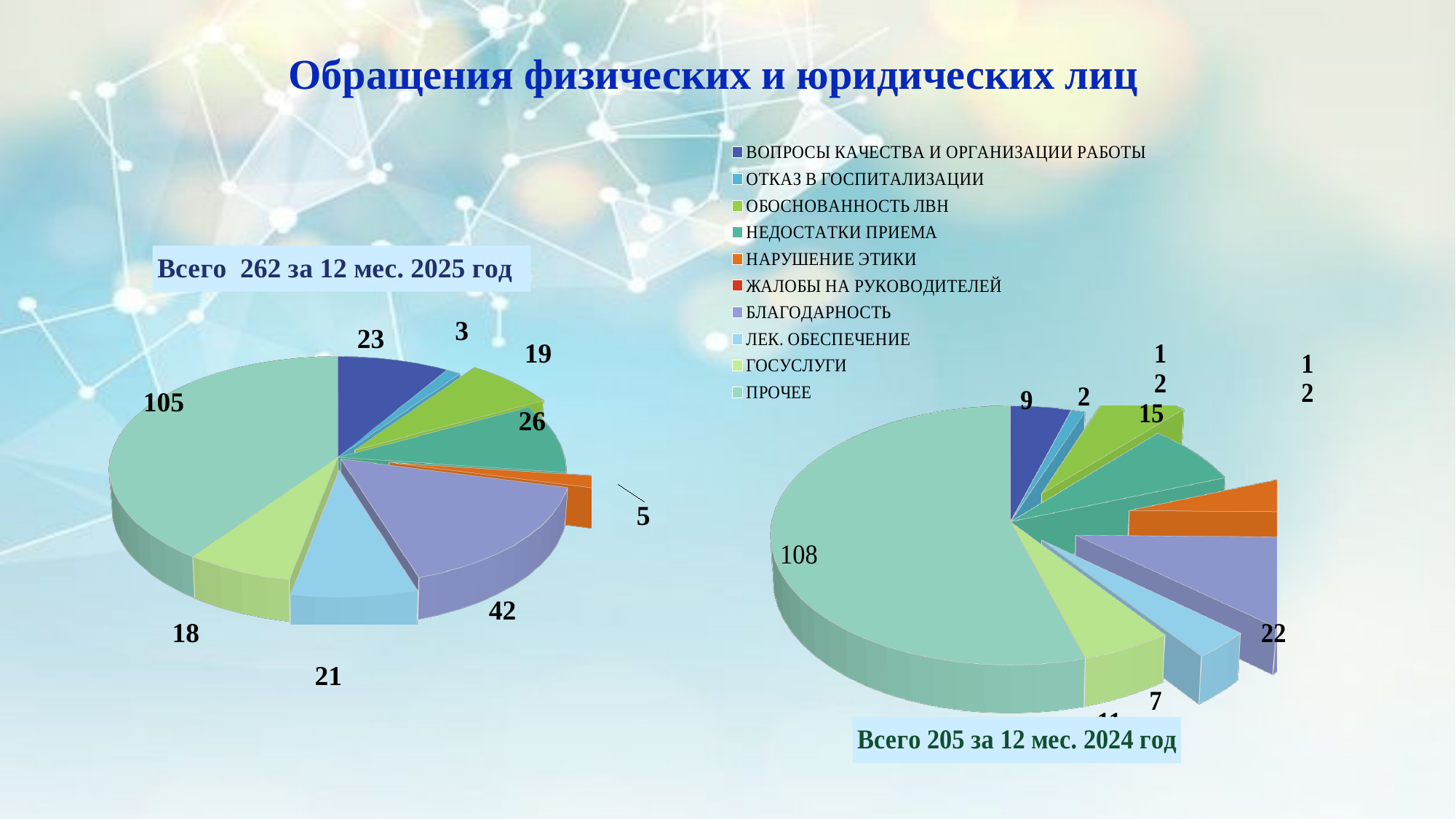
In the left chart (2025), which category has the largest slice? ПРОЧЕЕ In the right chart (2024), what is the value for ПРОЧЕЕ? 108 In the left chart (2025), what is the value for ЛЕК. ОБЕСПЕЧЕНИЕ? 21 What kind of chart is the left chart (Всего 262 за 12 мес. 2025 год)? pie chart In the left chart (2025), what is the value for БЛАГОДАРНОСТЬ? 42 In the left chart (2025), what is the difference between the values for ПРОЧЕЕ and БЛАГОДАРНОСТЬ? 63 In the left chart (2025), what is the value for ПРОЧЕЕ? 105 In the left chart (2025), what is the smallest value labeled on the chart? 3 What is the difference between the total for 2025 (262) and the total for 2024 (205) shown on the slide? 57 In the right chart (2024), what is the value for БЛАГОДАРНОСТЬ? 22 How many entries does the legend list? 10 In the left chart (2025), which is larger: НЕДОСТАТКИ ПРИЕМА or ВОПРОСЫ КАЧЕСТВА И ОРГАНИЗАЦИИ РАБОТЫ? НЕДОСТАТКИ ПРИЕМА